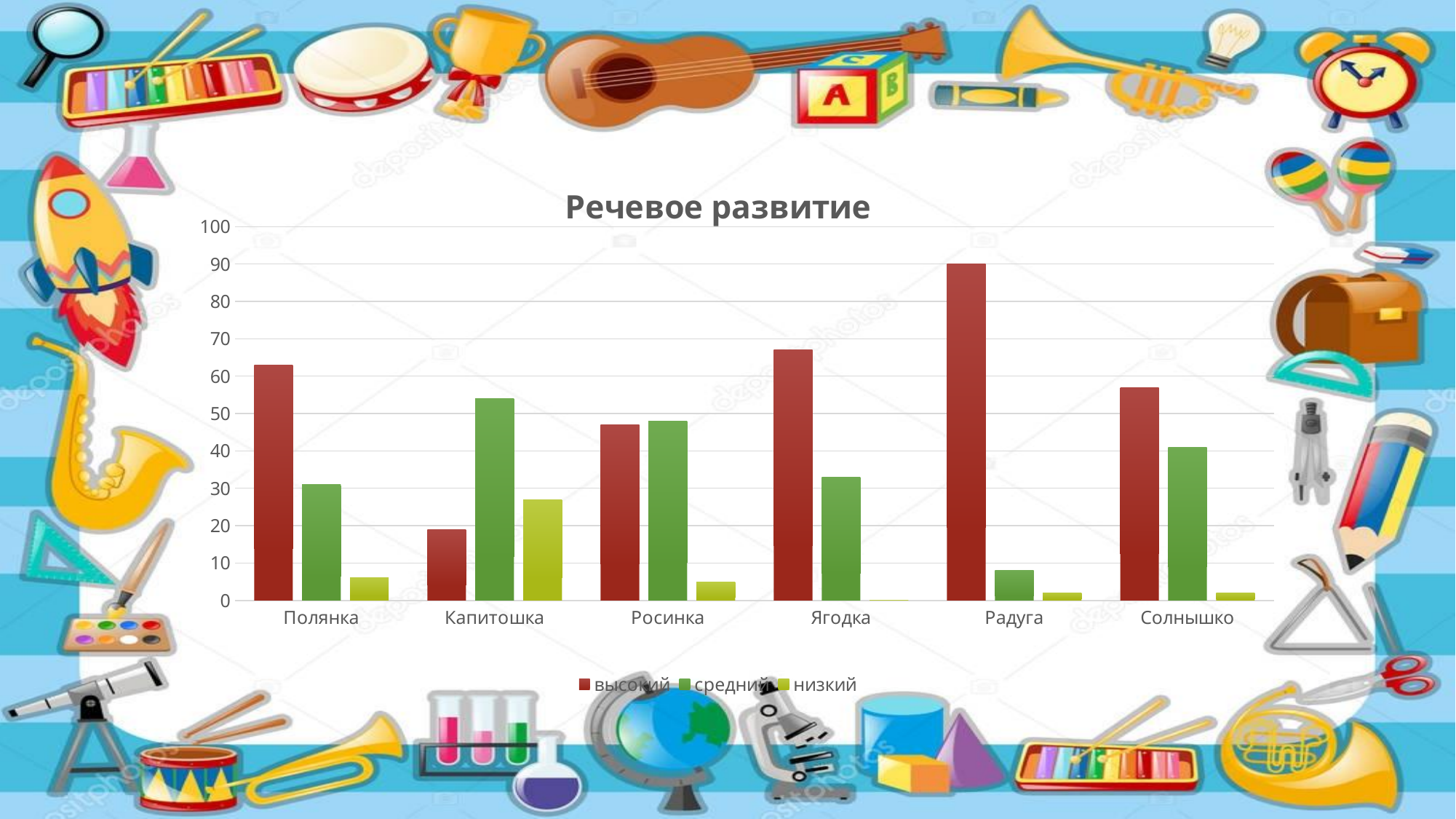
What is the title of the chart? Речевое развитие How many categories are shown on the x axis? 6 Which category has the lowest value for высокий? Капитошка Which series is shown in red in the legend? высокий Is the value of низкий for Капитошка greater or less than 30? less Which is larger for Солнышко: высокий or средний? высокий What is the value of высокий for Радуга? 90 Which category has the highest value for высокий? Радуга What kind of chart is shown on the slide? bar chart Which category has the highest value for средний? Капитошка Is the value of высокий for Полянка greater or less than 60? greater How many series does the legend list? 3